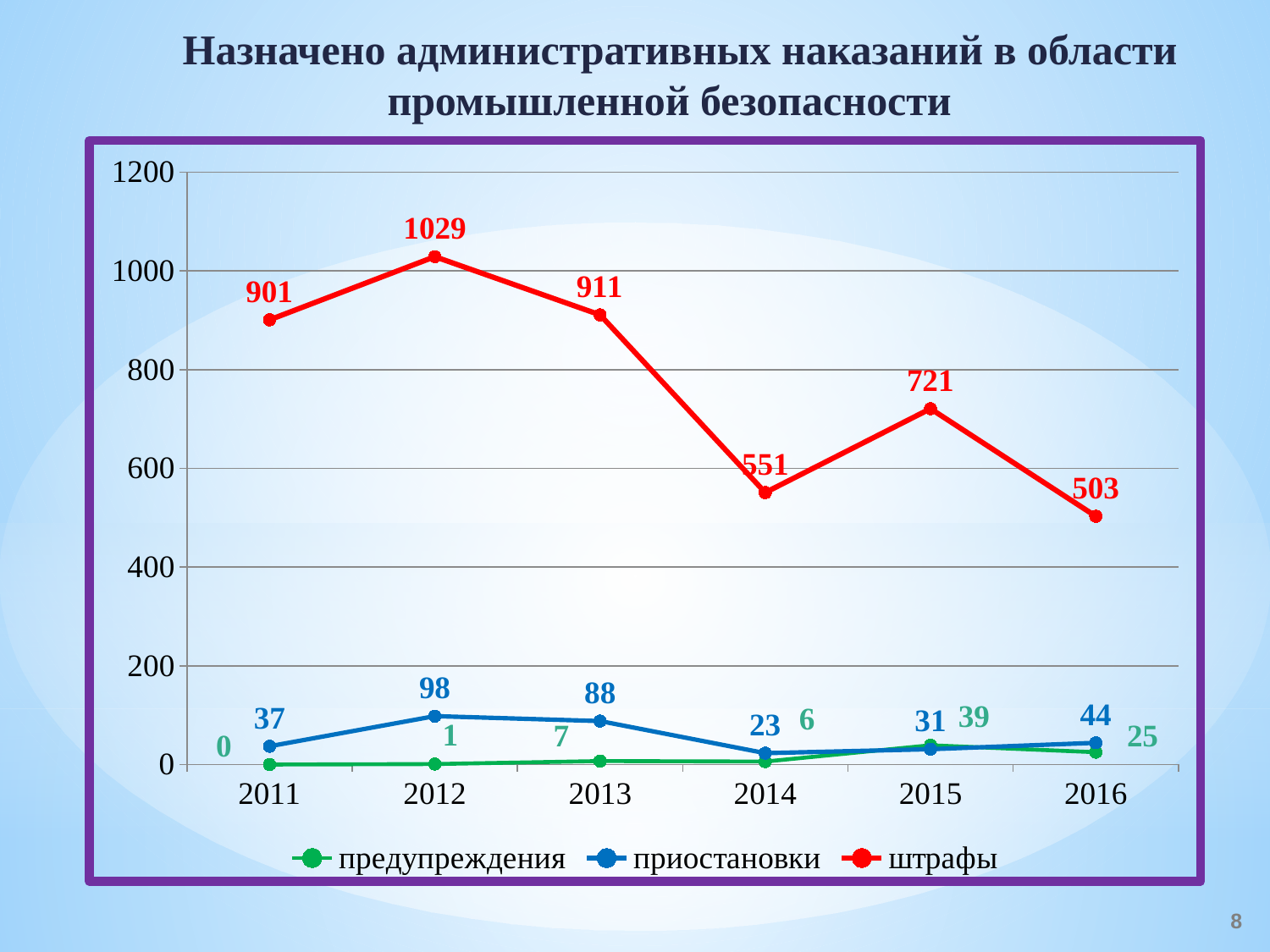
What is the value for штрафы in 2012? 1029 In which year is the value for штрафы highest? 2012 What type of chart is shown on the slide? line chart What is the value for приостановки in 2013? 88 What is the difference between the штрафы values for 2013 and 2014? 360 What is the value for предупреждения in 2015? 39 Which series is drawn in red? штрафы In which year is the value for штрафы lowest? 2016 Which is larger in 2016: приостановки or предупреждения? приостановки How many years are shown on the x axis? 6 Is the value for штрафы in 2015 greater or less than 600? greater How many series does the legend list? 3